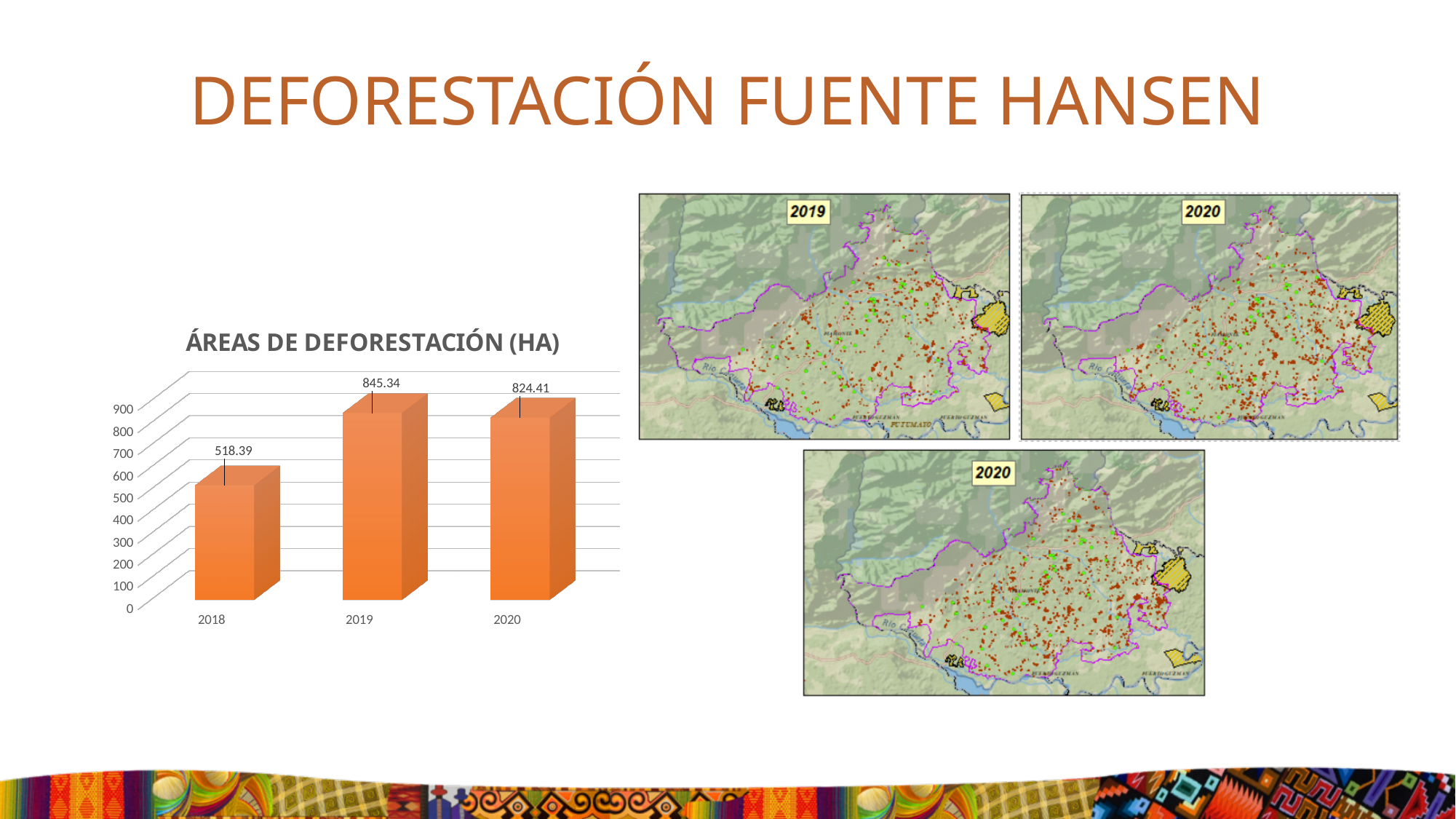
What is the difference between the 2019 and 2020 values in the bar chart? 20.93 What is the value for 2018 in the bar chart? 518.39 Which year has the highest deforestation area in the bar chart? 2019 Which year has the lowest deforestation area in the bar chart? 2018 What is the title of the bar chart? ÁREAS DE DEFORESTACIÓN (HA) What is the value for 2020 in the bar chart? 824.41 How many years are shown in the bar chart? 3 What is the difference between the 2019 and 2018 values in the bar chart? 326.95 Which is larger in the bar chart, the value for 2018 or the value for 2020? 2020 Is the value for 2018 greater or less than 600? less What kind of chart is used to show the deforestation areas? bar chart What is the value for 2019 in the bar chart? 845.34